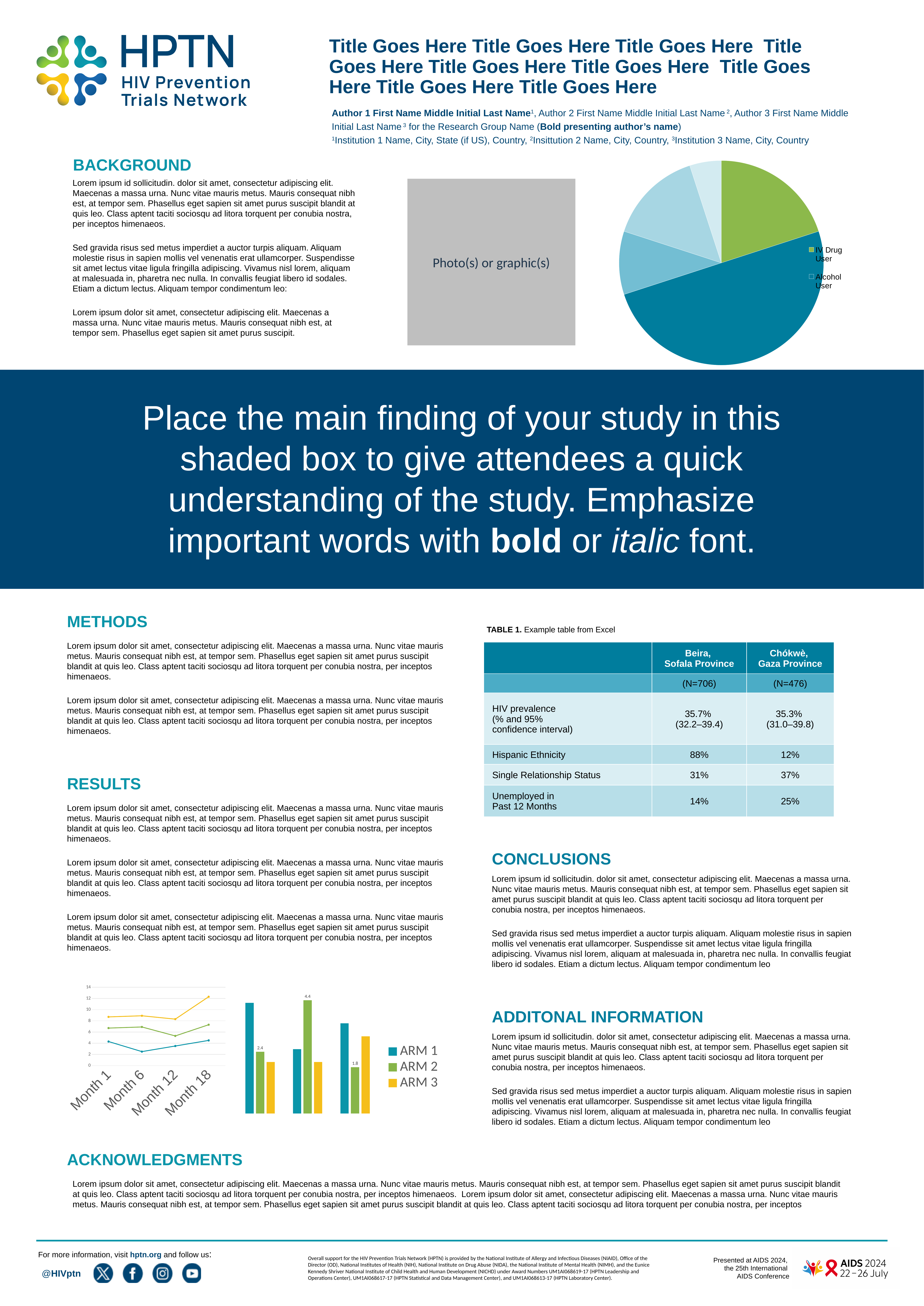
In the line chart at the bottom left, does the yellow line rise or fall between Month 12 and Month 18? rise In the line chart at the bottom left, is the value of the yellow line at Month 18 greater or less than 10? greater What kind of chart is shown at the bottom left of the slide, with Month 1 to Month 18 on the x axis? line chart What kind of chart is shown next to the ARM 1 / ARM 2 / ARM 3 legend at the bottom of the slide? bar chart What kind of chart is shown at the top right of the slide? pie chart In the bar chart at the bottom of the slide, what is the difference between the highest and lowest ARM 2 data labels (4.4 and 1.8)? 2.6 In the pie chart at the top right, which legend entry is marked with a green square? IV Drug User How many categories are on the x axis of the line chart at the bottom left? 4 How many series does the legend of the bar chart at the bottom of the slide list? 3 In the bar chart at the bottom of the slide, what is the highest data label shown for ARM 2? 4.4 In the line chart at the bottom left, is the value of the teal line at Month 6 greater or less than 4? less How many slices does the pie chart at the top right have? 5